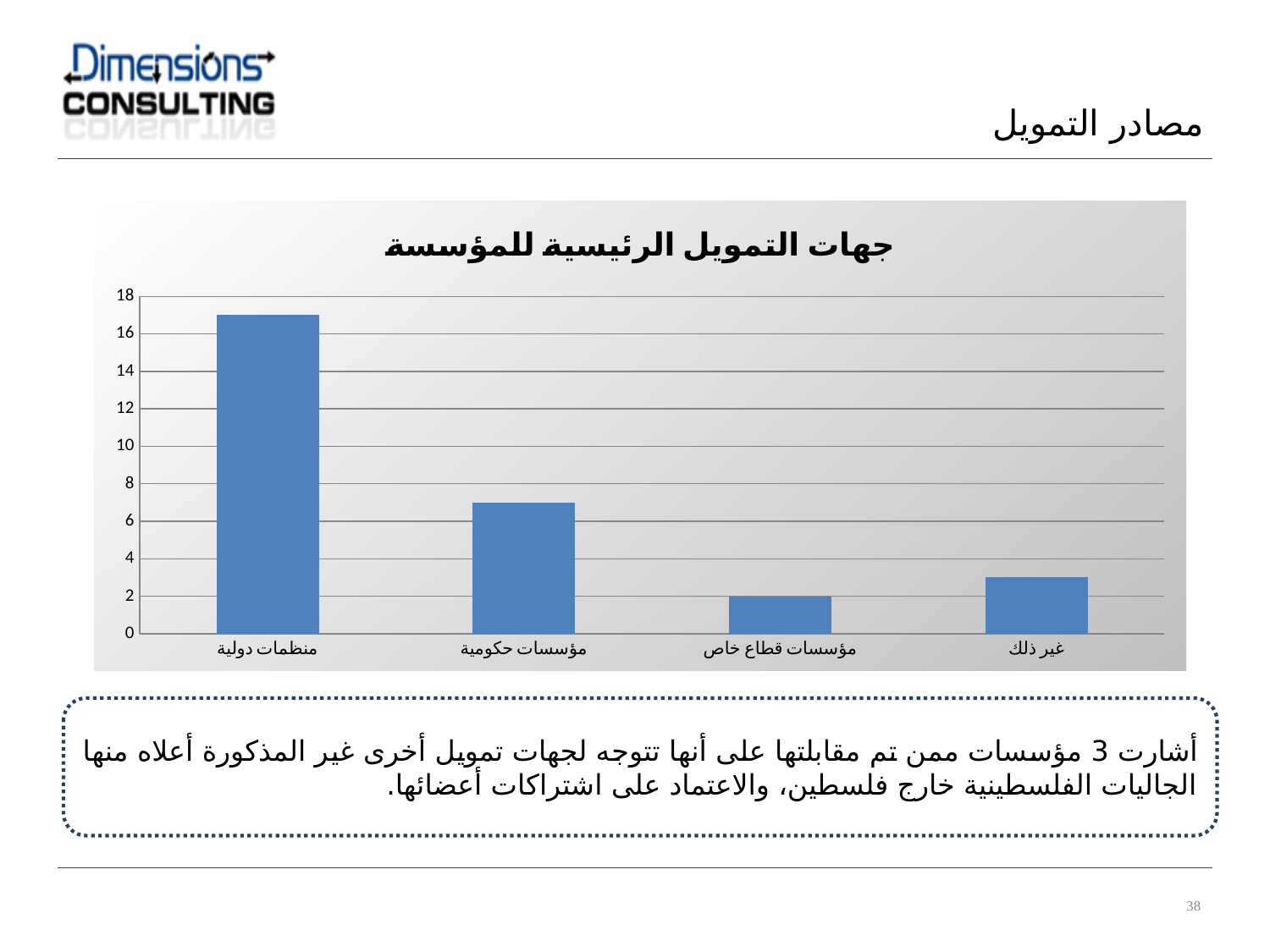
Is the value for منظمات دولية greater or less than 16? greater What is the title of the chart? جهات التمويل الرئيسية للمؤسسة Which category has the highest bar in the chart? منظمات دولية Is the value for غير ذلك greater or less than 4? less How many categories are shown on the x axis of the chart? 4 What is the highest value shown on the vertical axis of the chart? 18 Which category has the lowest bar in the chart? مؤسسات قطاع خاص What kind of chart is shown on the slide? bar chart Which is larger, the value for غير ذلك or the value for مؤسسات قطاع خاص? غير ذلك Which is larger, the value for مؤسسات حكومية or the value for غير ذلك? مؤسسات حكومية What is the value for مؤسسات قطاع خاص? 2 Is the value for مؤسسات حكومية greater or less than 8? less